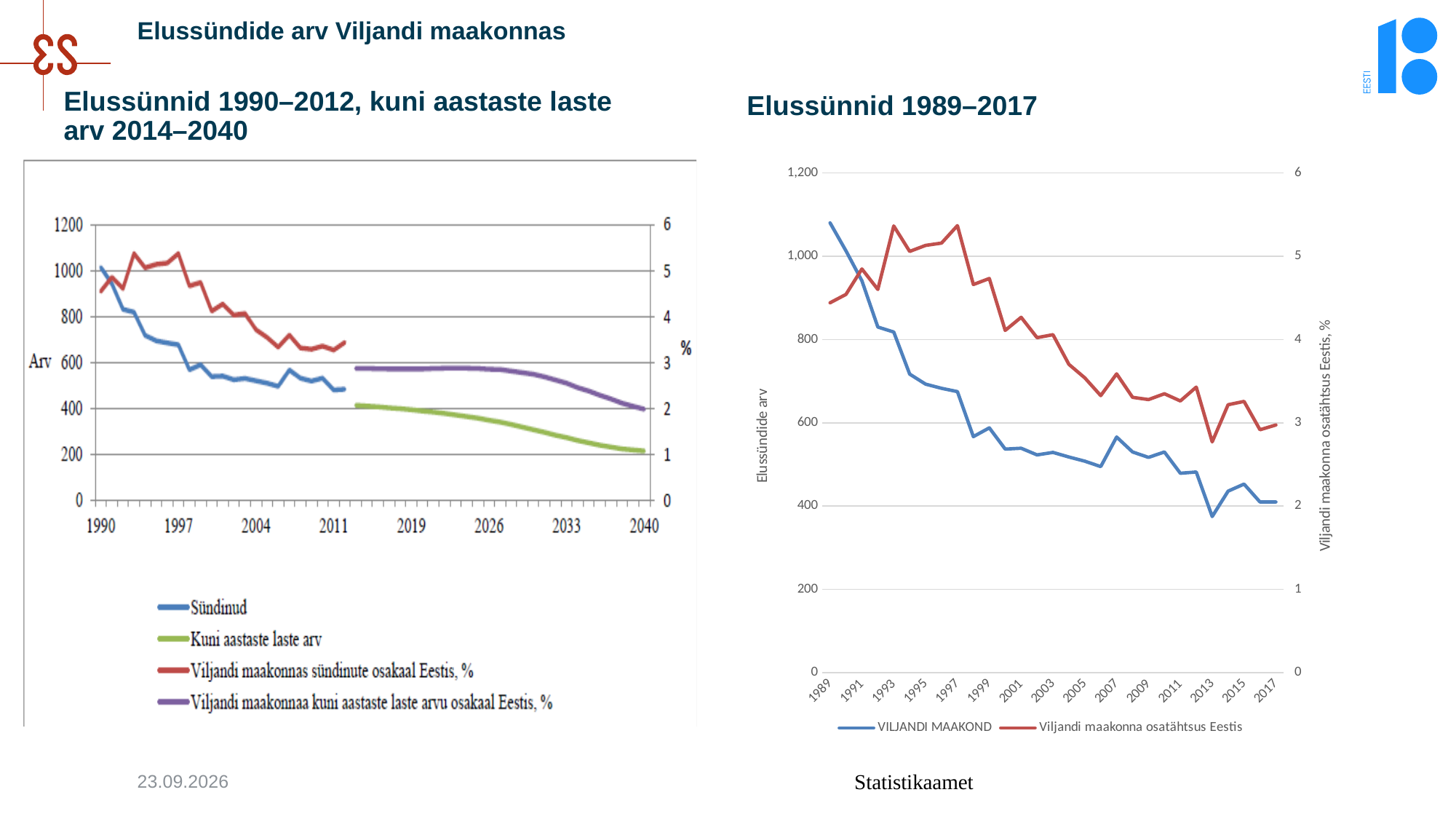
In the 'Elussünnid 1989–2017' chart, is the 'Viljandi maakonna osatähtsus Eestis' value for 1993 greater or less than 5? greater In the left chart, is the 'Kuni aastaste laste arv' value for 2040 greater or less than 400? less In the 'Elussünnid 1989–2017' chart, which year has the highest VILJANDI MAAKOND value? 1989 In the 'Elussünnid 1989–2017' chart, does the VILJANDI MAAKOND line rise or fall from 1989 to 2017? fall In the 'Elussünnid 1989–2017' chart, is the VILJANDI MAAKOND value for 2017 greater or less than 600? less How many series does the legend of the left chart ('Elussünnid 1990–2012, kuni aastaste laste arv 2014–2040') list? 4 In the left chart, which series is drawn in green? Kuni aastaste laste arv In the 'Elussünnid 1989–2017' chart, which year has the lowest VILJANDI MAAKOND value? 2013 How many series does the legend of the 'Elussünnid 1989–2017' chart list? 2 What kind of chart is the 'Elussünnid 1989–2017' chart on the right? line chart